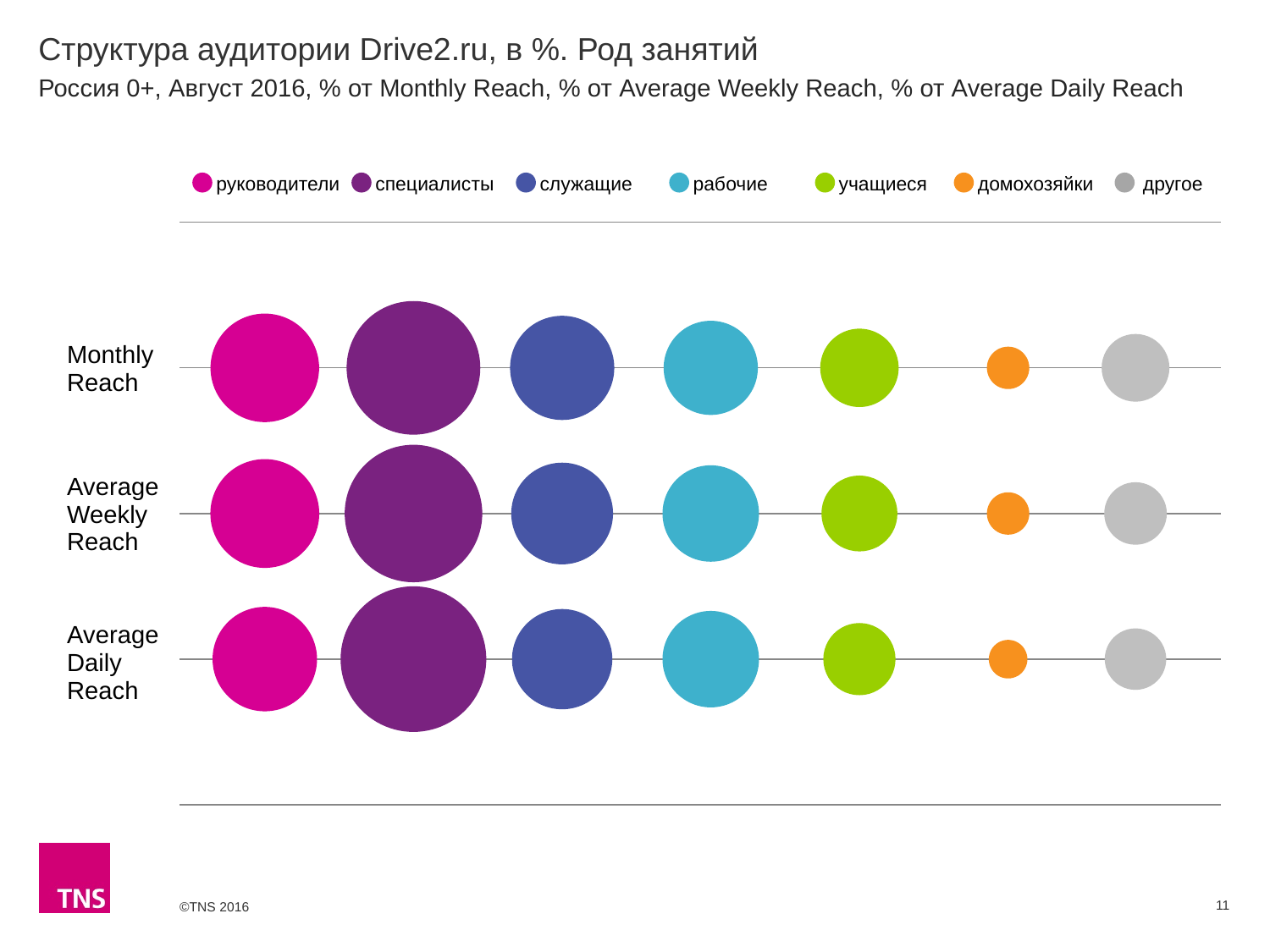
Which occupation group has the smallest bubble in the Average Weekly Reach row? домохозяйки Which occupation group has the smallest bubble in the Monthly Reach row? домохозяйки How many occupation groups does the legend list? 7 How many reach categories (rows) are plotted on the chart? 3 In the Monthly Reach row, which bubble is larger: другое or домохозяйки? другое What is the title of the chart on the slide? Структура аудитории Drive2.ru, в %. Род занятий Which occupation group has the largest bubble in the Average Daily Reach row? специалисты Which occupation group has the largest bubble in the Monthly Reach row? специалисты In the Average Daily Reach row, which bubble is larger: специалисты or служащие? специалисты In the Average Weekly Reach row, which bubble is larger: руководители or учащиеся? руководители What kind of chart is shown on the slide? Bubble chart What colour represents the group рабочие in the legend? Light blue